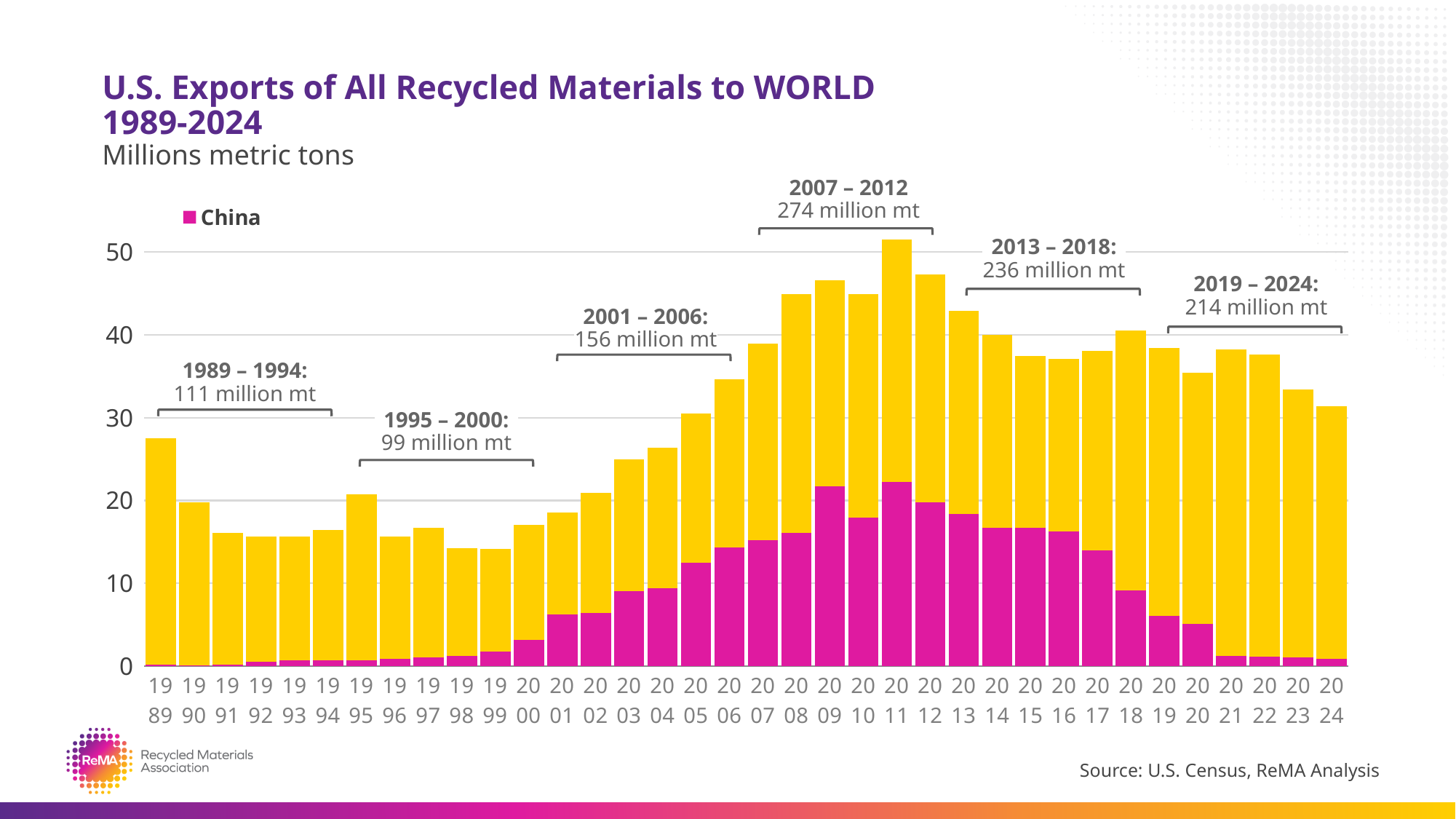
Which series is listed in the chart's legend? China What total is annotated for the period 2019 – 2024? 214 million mt What kind of chart is shown on the slide? bar chart Which annotated period has the lowest total, 1989 – 1994 or 1995 – 2000? 1995 – 2000 How many years are shown along the x axis? 36 What total is annotated for the period 1995 – 2000? 99 million mt Is the total bar for 2011 greater or less than 50? greater What is the difference between the annotated totals for 2007 – 2012 and 2013 – 2018? 38 million mt What is the title of the chart? U.S. Exports of All Recycled Materials to WORLD 1989-2024 Is the total bar for 1999 greater or less than 20? less Which year has the tallest bar? 2011 What total is annotated for the period 2007 – 2012? 274 million mt